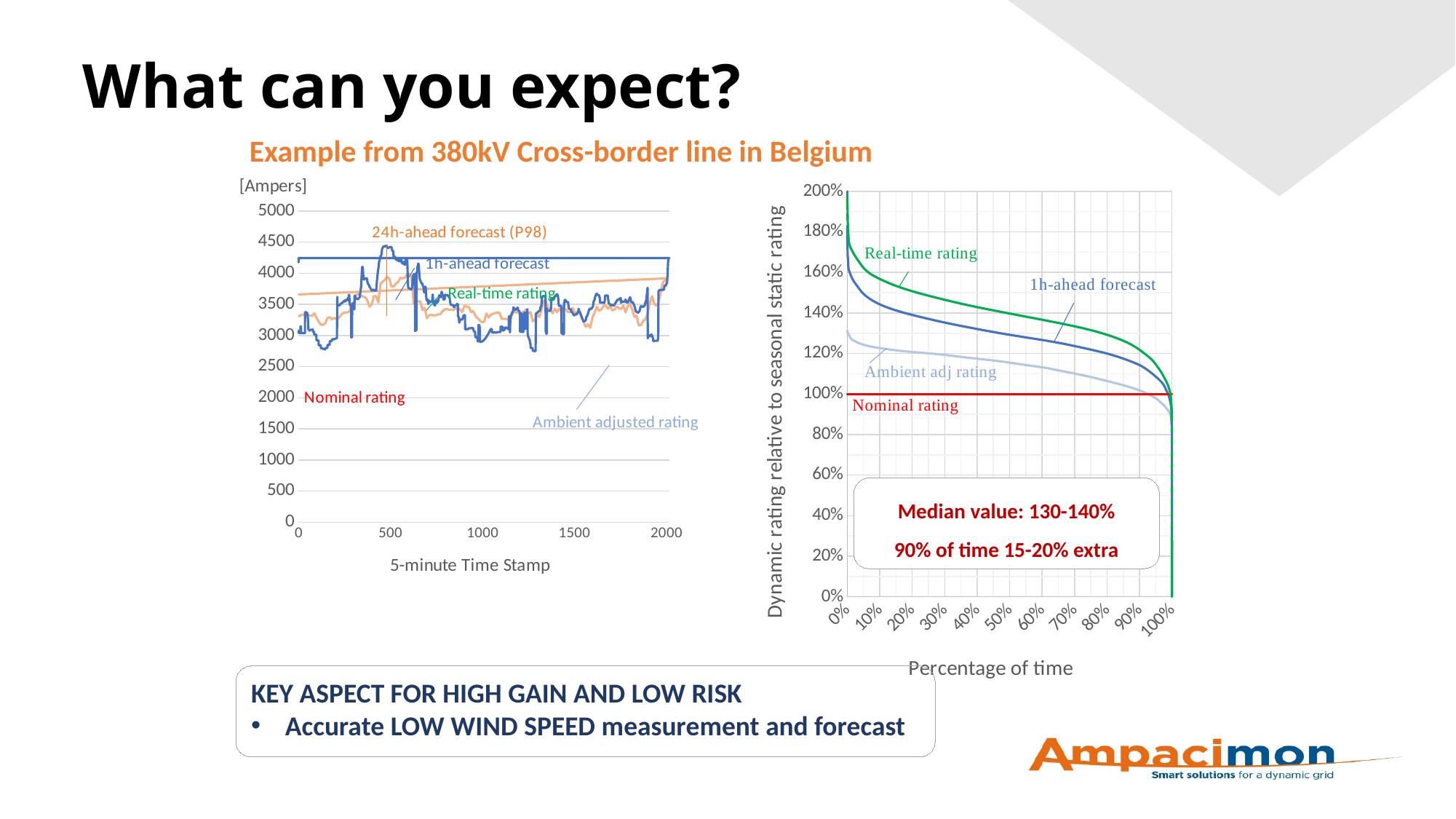
What is the x-axis label of the left-hand chart? 5-minute Time Stamp In the right-hand chart, which of the curved series is lowest across most of the percentage-of-time range? Ambient adj rating How many labelled series are shown in the right-hand chart? 4 In the right-hand chart, is the Ambient adj rating at 50% of time greater or less than 120%? less In the right-hand chart, at what value does the Nominal rating line sit? 100% What kind of chart is the left-hand chart with the [Ampers] axis? line chart In the right-hand chart, is the Real-time rating at 50% of time greater or less than 120%? greater In the right-hand chart, which series is highest across most of the percentage-of-time range? Real-time rating In the right-hand chart, do the rating curves rise or fall as percentage of time increases? fall In the right-hand chart, is the 1h-ahead forecast at 20% of time greater or less than 120%? greater What kind of chart is the right-hand chart (Dynamic rating relative to seasonal static rating)? line chart What is the x-axis label of the right-hand chart? Percentage of time